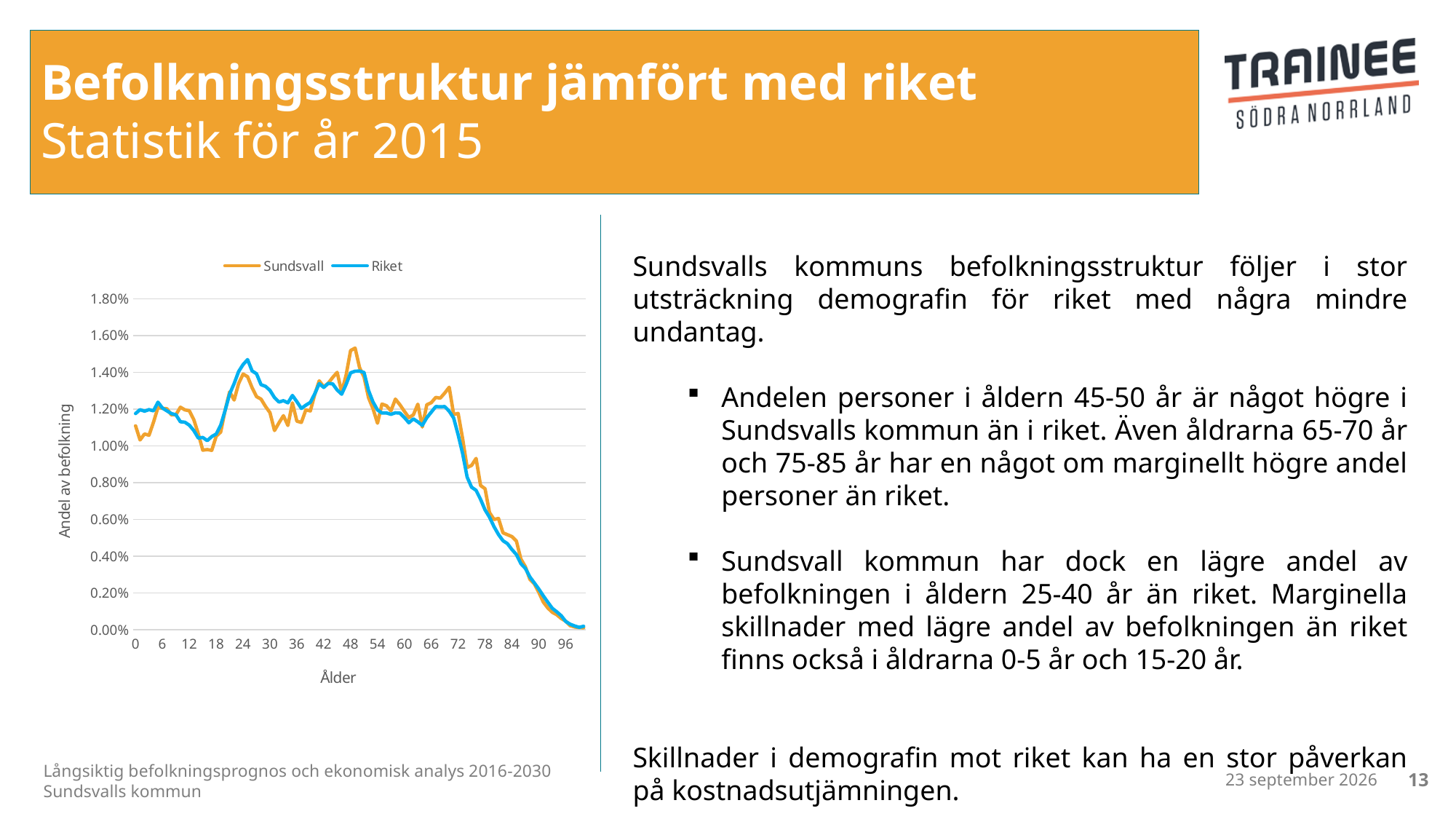
Do the values for both series rise or fall along the x axis from age 72 to age 96? Fall What kind of chart is shown on the slide? Line chart Is the value for Riket at age 84 greater or less than 0.60%? less Is the value for Sundsvall at age 48 greater or less than 1.40%? greater What is the title of the chart's vertical axis? Andel av befolkning At age 30, which series has the higher value, Sundsvall or Riket? Riket Which series reaches the highest peak value in the chart? Sundsvall Is the value for Riket at age 24 greater or less than 1.40%? greater What are the two series named in the chart's legend? Sundsvall and Riket How many series does the chart's legend list? 2 At age 48, which series has the higher value, Sundsvall or Riket? Sundsvall